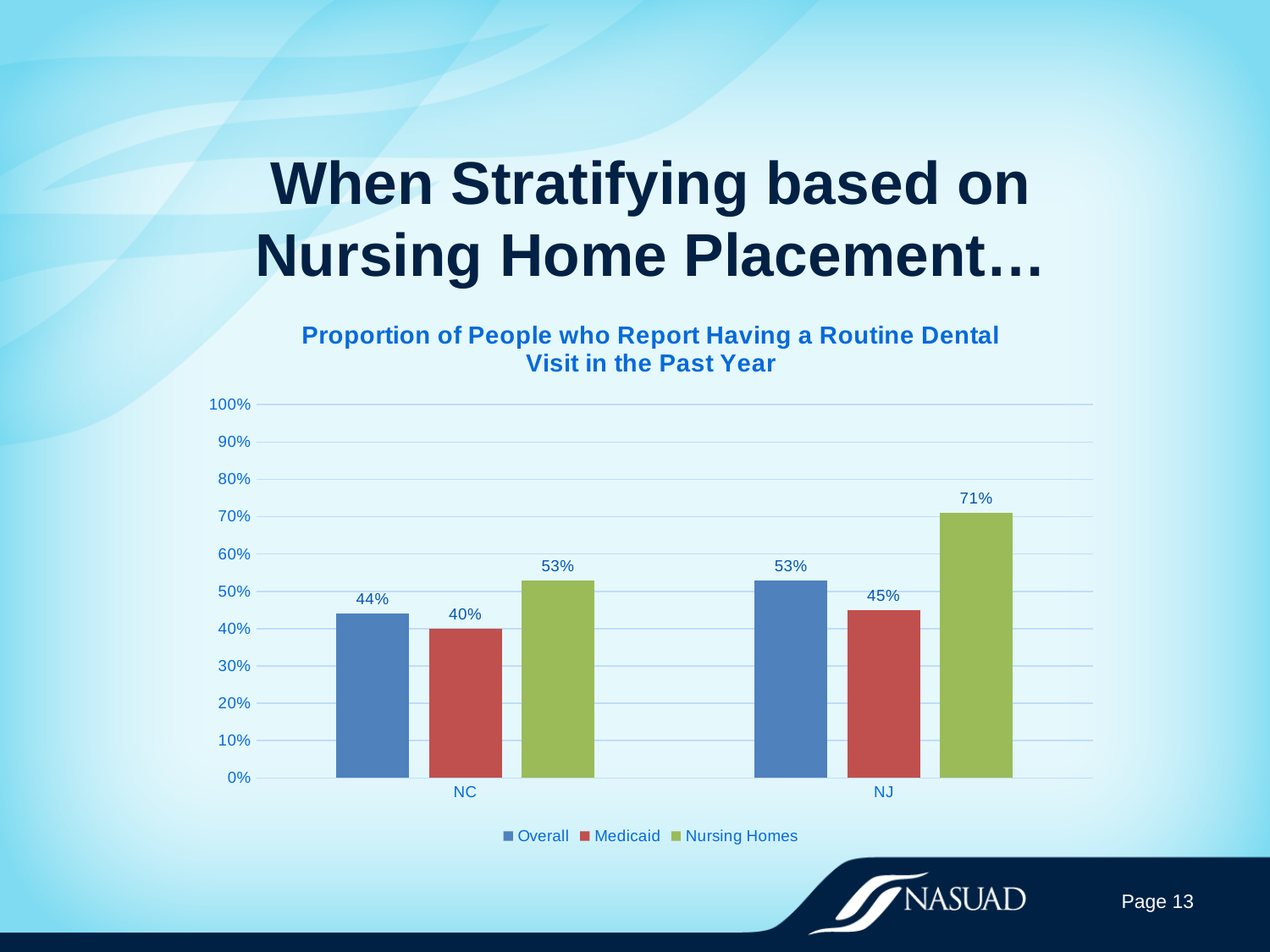
Which series has the highest value in NJ? Nursing Homes What is the value for Nursing Homes in NJ? 71% How many series does the legend list? 3 How many categories are shown on the x axis? 2 What kind of chart is shown on the slide? Bar chart Which is larger, the Medicaid value for NC or the Medicaid value for NJ? NJ What is the difference between the Overall and Medicaid values in NC? 4% What is the Overall value for NJ? 53% What is the title of the chart? Proportion of People who Report Having a Routine Dental Visit in the Past Year Which series has the lowest value in NC? Medicaid What is the value for Medicaid in NC? 40% What is the difference between the Nursing Homes values for NJ and NC? 18%